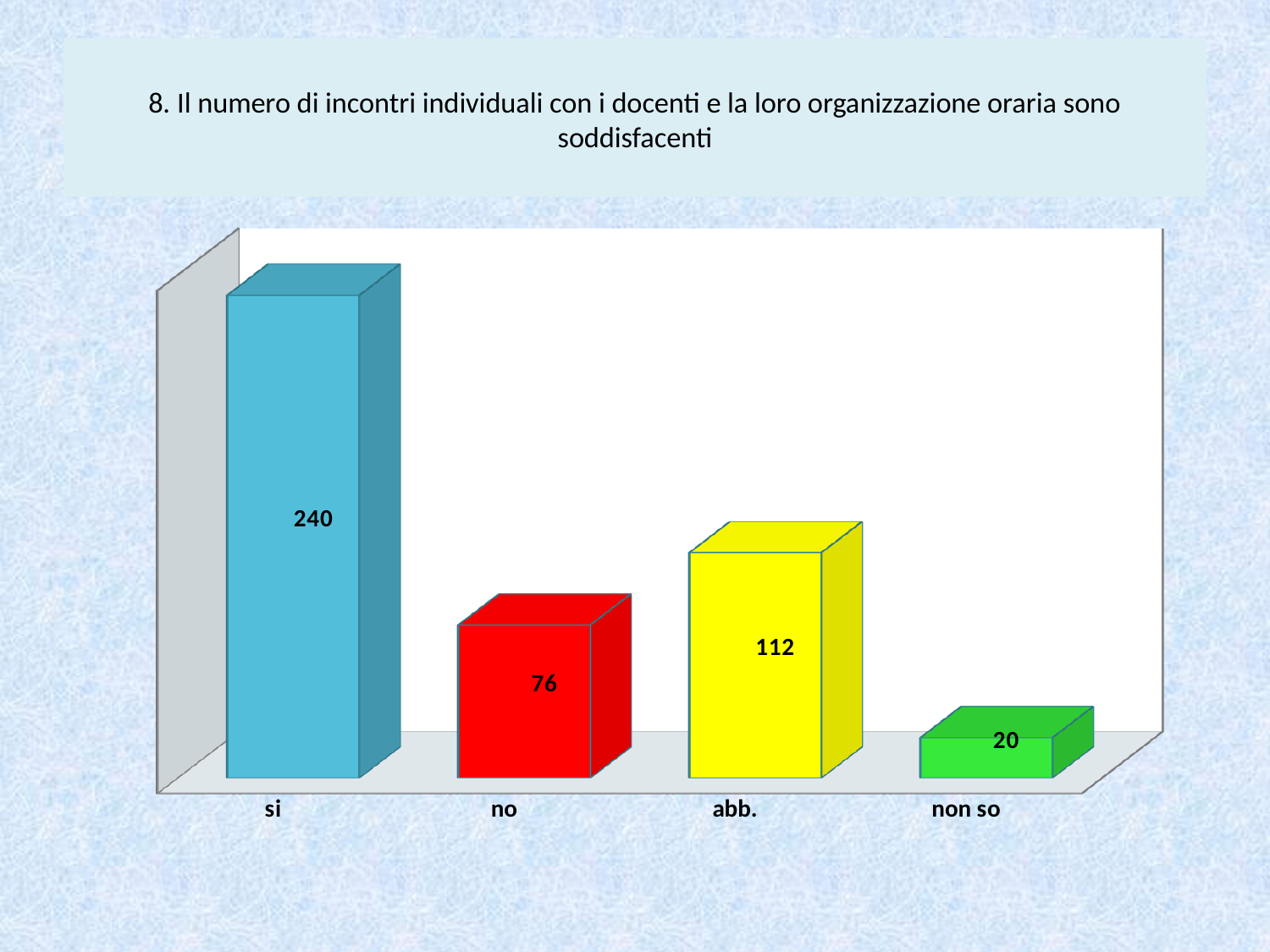
Which category has the lowest value? non so Which is larger, the value for "no" or the value for "abb."? abb. What is the value for "si"? 240 How many categories are shown on the x axis? 4 What is the value for "non so"? 20 What is the difference between the values for "abb." and "no"? 36 Which category has the highest value? si What is the value for "no"? 76 What is the value for "abb."? 112 What kind of chart is shown on the slide? bar chart What colour is the bar for "abb."? yellow What is the difference between the values for "si" and "abb."? 128